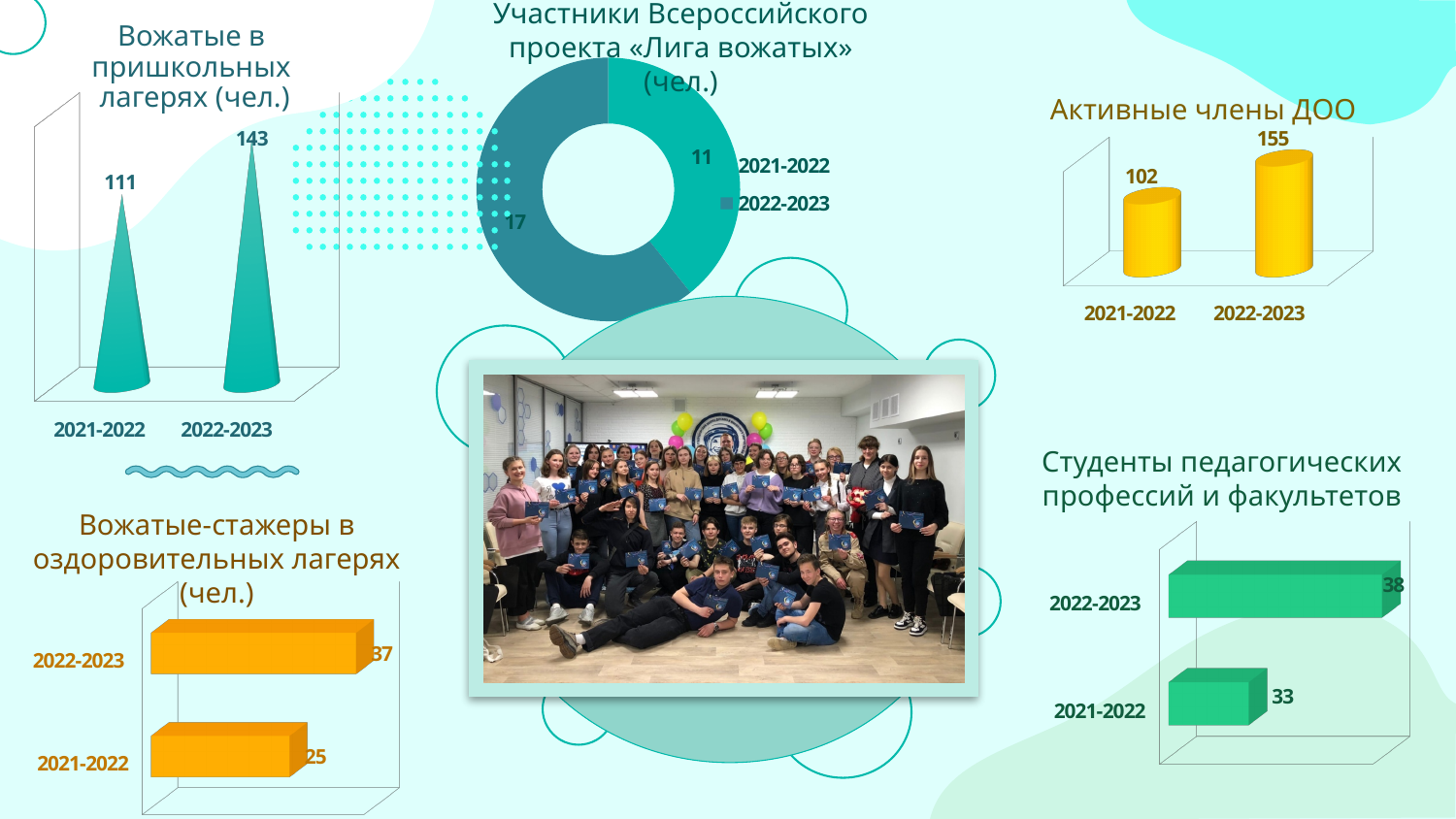
How many categories are shown in the chart titled «Активные члены ДОО»? 2 In the doughnut chart titled «Участники Всероссийского проекта «Лига вожатых» (чел.)», what is the value for 2022-2023? 17 In the chart titled «Активные члены ДОО», what is the value for 2021-2022? 102 In the chart titled «Студенты педагогических профессий и факультетов», what is the difference between the 2022-2023 and 2021-2022 values? 5 In the chart titled «Вожатые-стажеры в оздоровительных лагерях (чел.)», what is the value for 2021-2022? 25 In the chart titled «Участники Всероссийского проекта «Лига вожатых» (чел.)», what is the total of the two segments? 28 In the chart titled «Студенты педагогических профессий и факультетов», what is the value for 2022-2023? 38 In the chart titled «Вожатые в пришкольных лагерях (чел.)», what is the value for 2022-2023? 143 In the chart titled «Вожатые в пришкольных лагерях (чел.)», what is the difference between the 2022-2023 and 2021-2022 values? 32 What kind of chart is the one titled «Участники Всероссийского проекта «Лига вожатых» (чел.)»? Doughnut chart In the chart titled «Активные члены ДОО», which category has the highest value? 2022-2023 In the chart titled «Вожатые-стажеры в оздоровительных лагерях (чел.)», which is larger, the value for 2022-2023 or for 2021-2022? 2022-2023